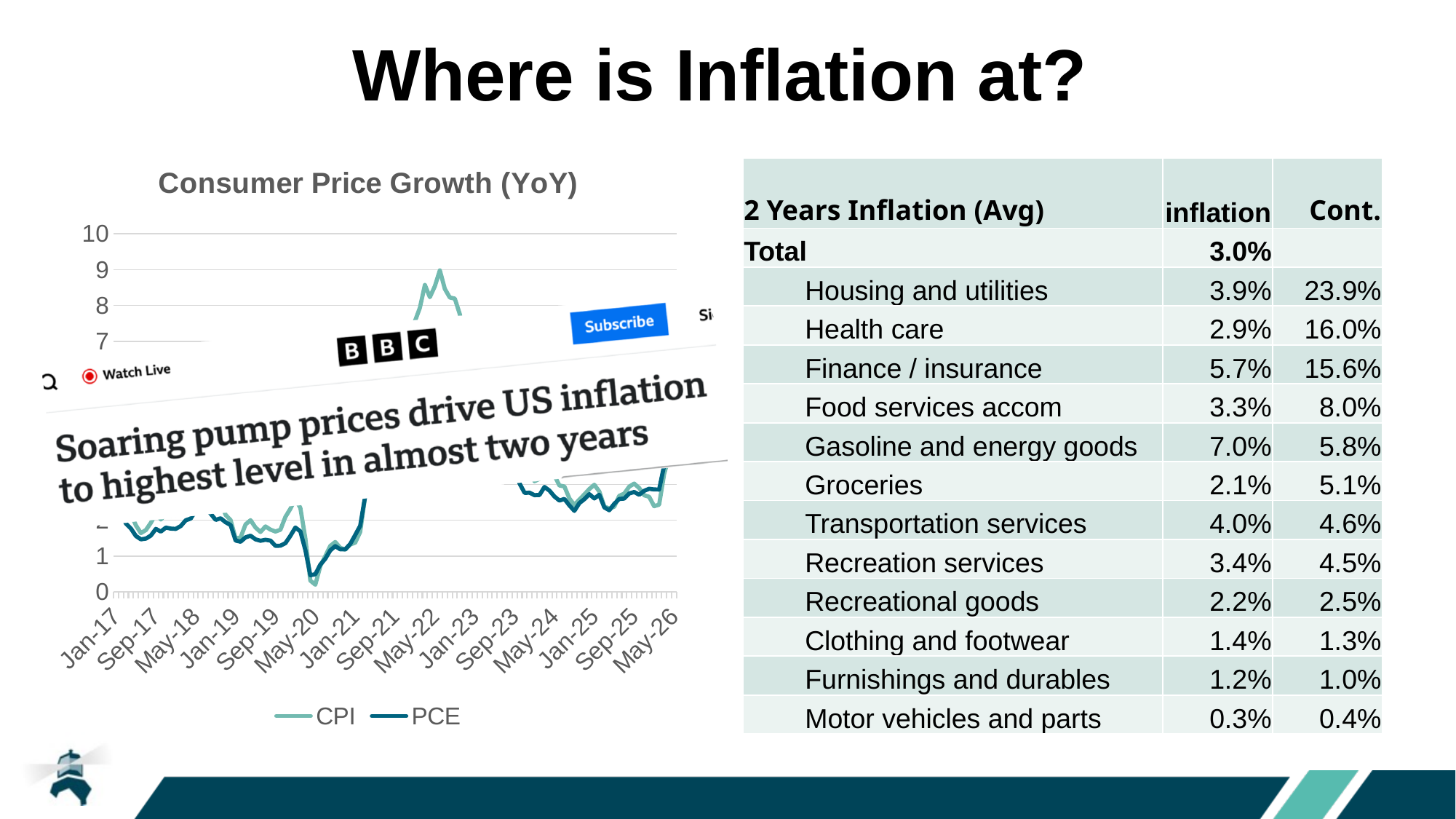
In the "Consumer Price Growth (YoY)" chart, is the CPI value at May-26 greater or less than 5? less How many date labels are shown on the x axis of the "Consumer Price Growth (YoY)" chart? 15 In the "Consumer Price Growth (YoY)" chart, is the peak CPI value around May-22 greater or less than 8? greater In the "Consumer Price Growth (YoY)" chart, is the lowest CPI value around May-20 greater or less than 1? less What is the title of the line chart on the slide? Consumer Price Growth (YoY) What is the highest value shown on the y axis of the "Consumer Price Growth (YoY)" chart? 10 In the "Consumer Price Growth (YoY)" chart, do the CPI values rise or fall between May-20 and Jan-21? rise In the "Consumer Price Growth (YoY)" chart, which series has the higher value around May-22: CPI or PCE? CPI How many series does the legend of the "Consumer Price Growth (YoY)" chart list? 2 What kind of chart is "Consumer Price Growth (YoY)"? line chart What are the two series shown in the "Consumer Price Growth (YoY)" chart? CPI and PCE